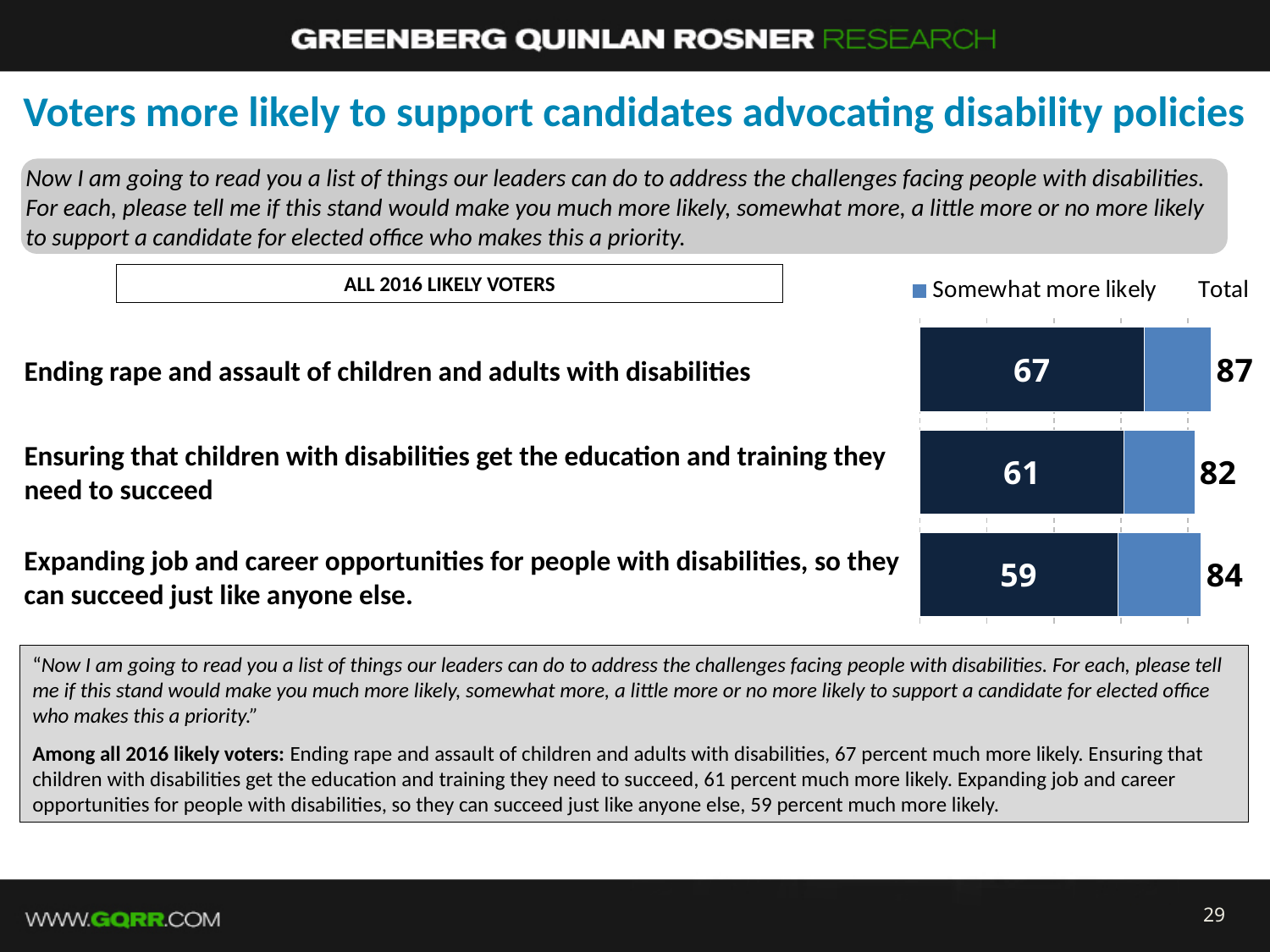
Based on the printed total and much more likely values, what is the somewhat more likely value for ending rape and assault of children and adults with disabilities? 20 Which policy has the highest total value? Ending rape and assault of children and adults with disabilities What is the total value shown for expanding job and career opportunities for people with disabilities? 84 What is the total value shown for ensuring that children with disabilities get the education and training they need to succeed? 82 How many policy items are shown in the chart? 3 What is the difference between the much more likely values for ending rape and assault and for ensuring education and training? 6 What type of chart is shown on the slide? Bar chart Which policy has the lowest much more likely value? Expanding job and career opportunities for people with disabilities What is the much more likely value for expanding job and career opportunities for people with disabilities? 59 Which has a larger total: ensuring education and training for children with disabilities, or expanding job and career opportunities? Expanding job and career opportunities Which policy has the highest much more likely value? Ending rape and assault of children and adults with disabilities What percentage of all 2016 likely voters say they are much more likely to support a candidate prioritizing ending rape and assault of children and adults with disabilities? 67